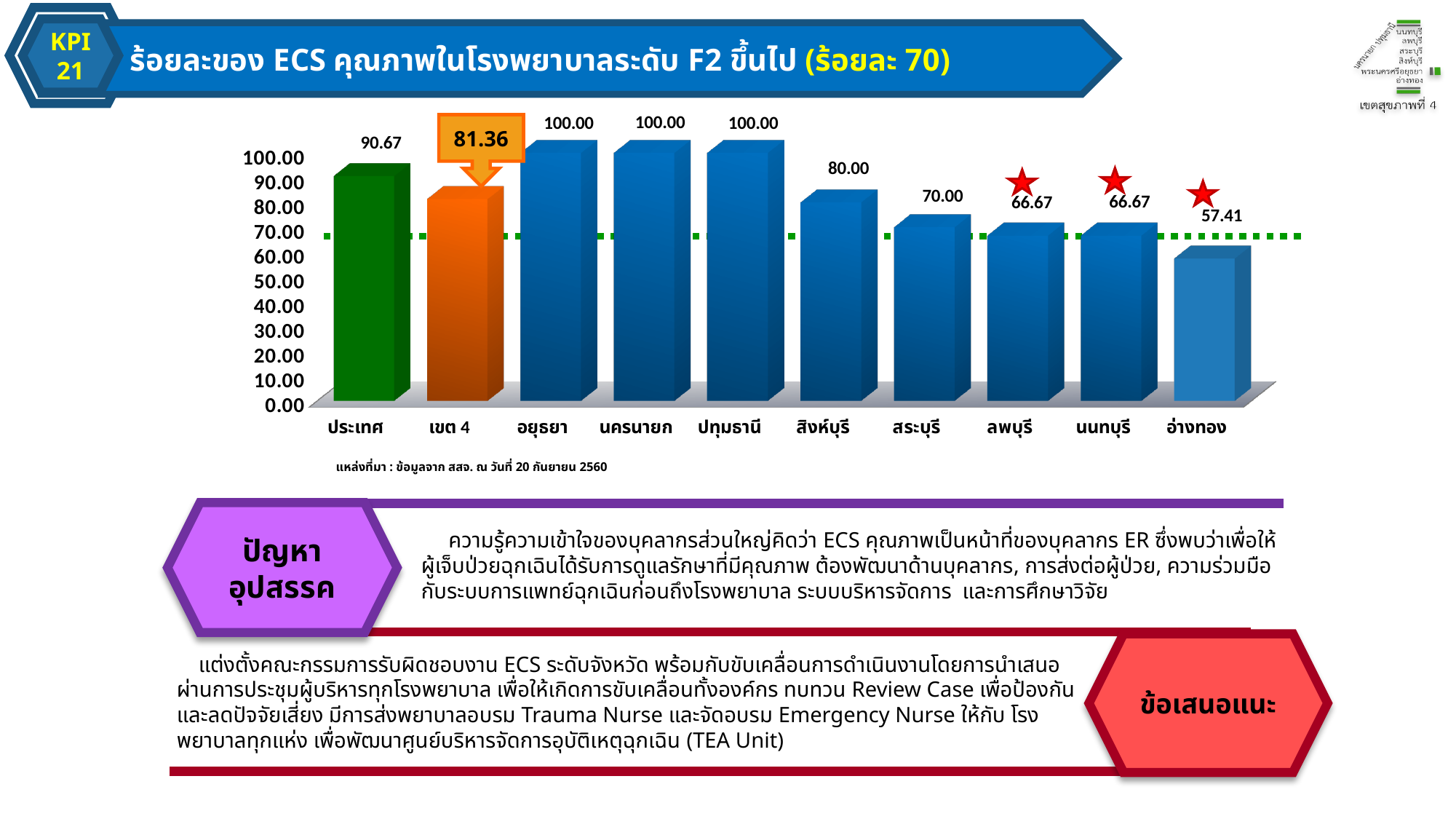
Which is larger, the value for สระบุรี or the value for ลพบุรี? สระบุรี What kind of chart is shown on the slide? bar chart What is the value for เขต 4? 81.36 What is the value for ประเทศ? 90.67 What is the value for อ่างทอง? 57.41 What is the value for สิงห์บุรี? 80.00 What is the difference between the values for สิงห์บุรี and อ่างทอง? 22.59 What value does the green dotted target line mark on the chart? 70.00 Which category has the lowest value? อ่างทอง Is the value for นนทบุรี greater or less than 70.00? less How many categories are shown on the x axis? 10 What is the difference between the values for ประเทศ and เขต 4? 9.31